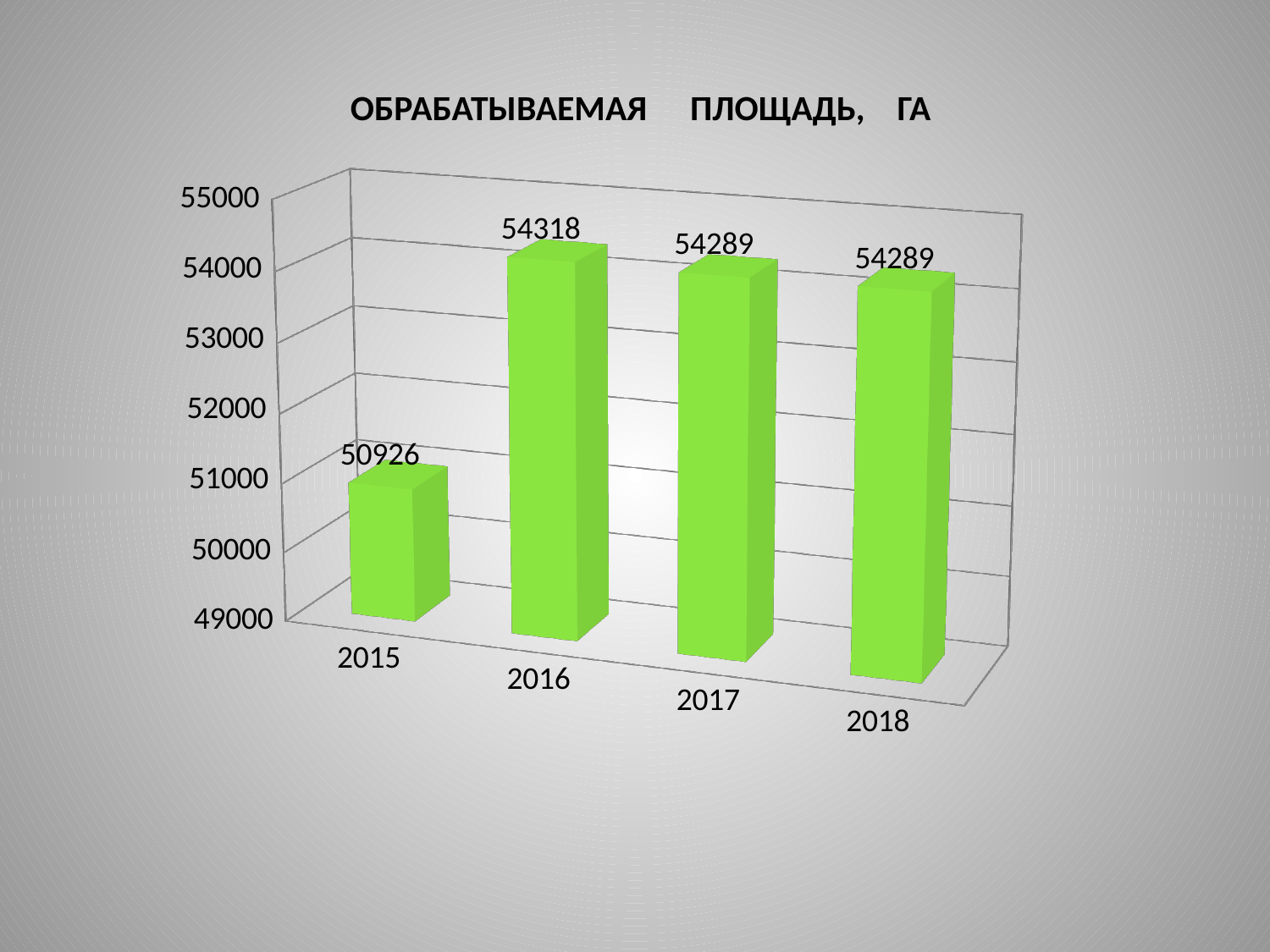
What kind of chart is shown on the slide? bar chart Which year has the lowest value? 2015 What is the value for 2017? 54289 What is the value for 2015? 50926 What is the difference between the values for 2016 and 2017? 29 What is the value for 2016? 54318 Is the value for 2015 greater or less than 52000? less How many years are shown on the chart? 4 What is the value for 2018? 54289 What is the difference between the values for 2016 and 2015? 3392 Which is larger, the value for 2015 or the value for 2018? 2018 Which year has the highest value? 2016